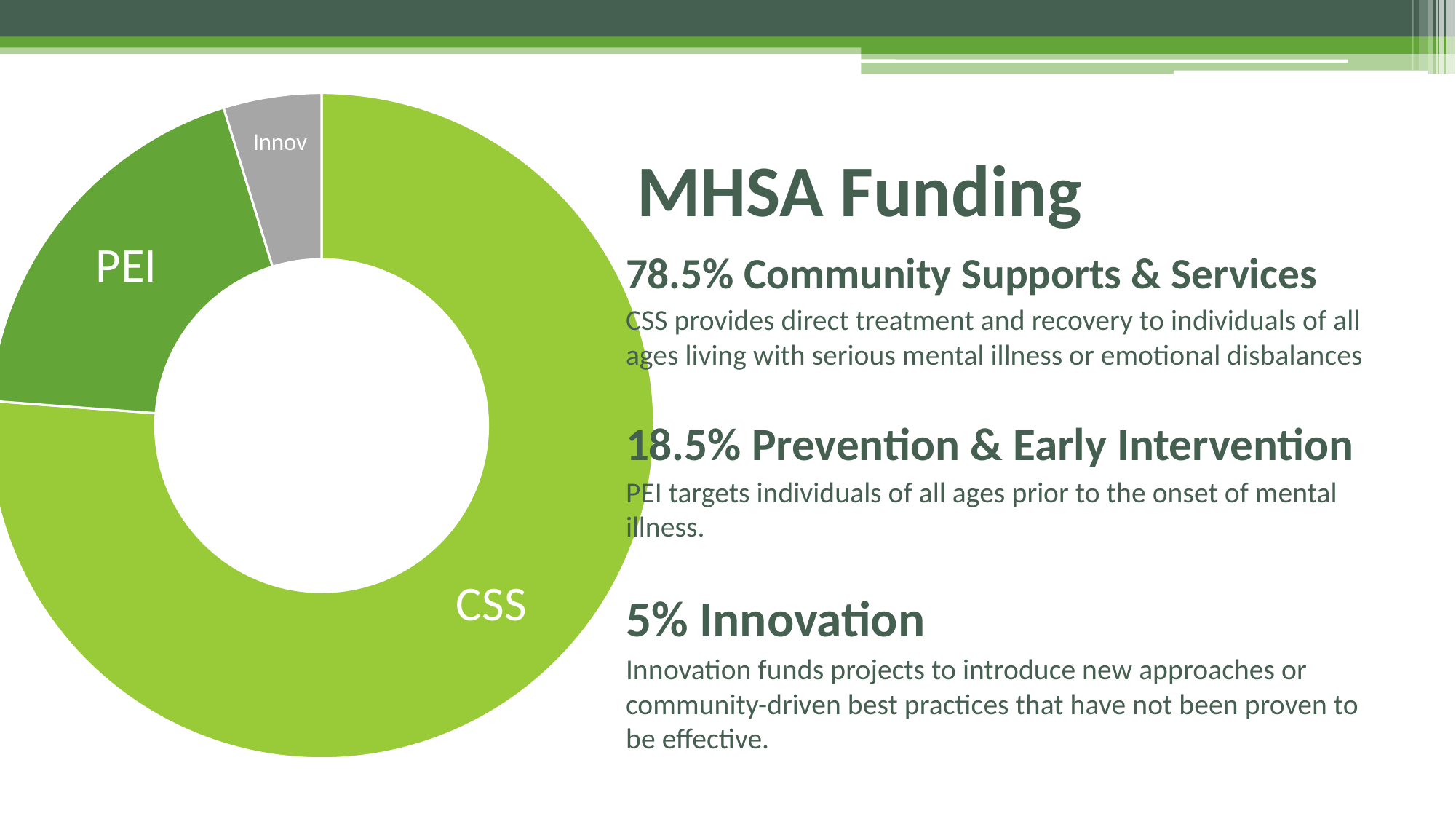
Which is larger in the doughnut chart, the PEI slice or the Innov slice? PEI What kind of chart is shown on the slide? Doughnut chart What share of MHSA funding goes to PEI according to the slide? 18.5% What colour is the Innov slice in the doughnut chart? Grey How many slices does the doughnut chart have? 3 What is the difference in percentage points between the PEI share and the Innovation share? 13.5 Which slice of the doughnut chart is the smallest? Innov What share of MHSA funding goes to CSS according to the slide? 78.5% What is the difference in percentage points between the CSS share and the PEI share? 60 What share of MHSA funding goes to Innovation according to the slide? 5% Which slice of the doughnut chart is the largest? CSS What is the title of the slide containing the doughnut chart? MHSA Funding